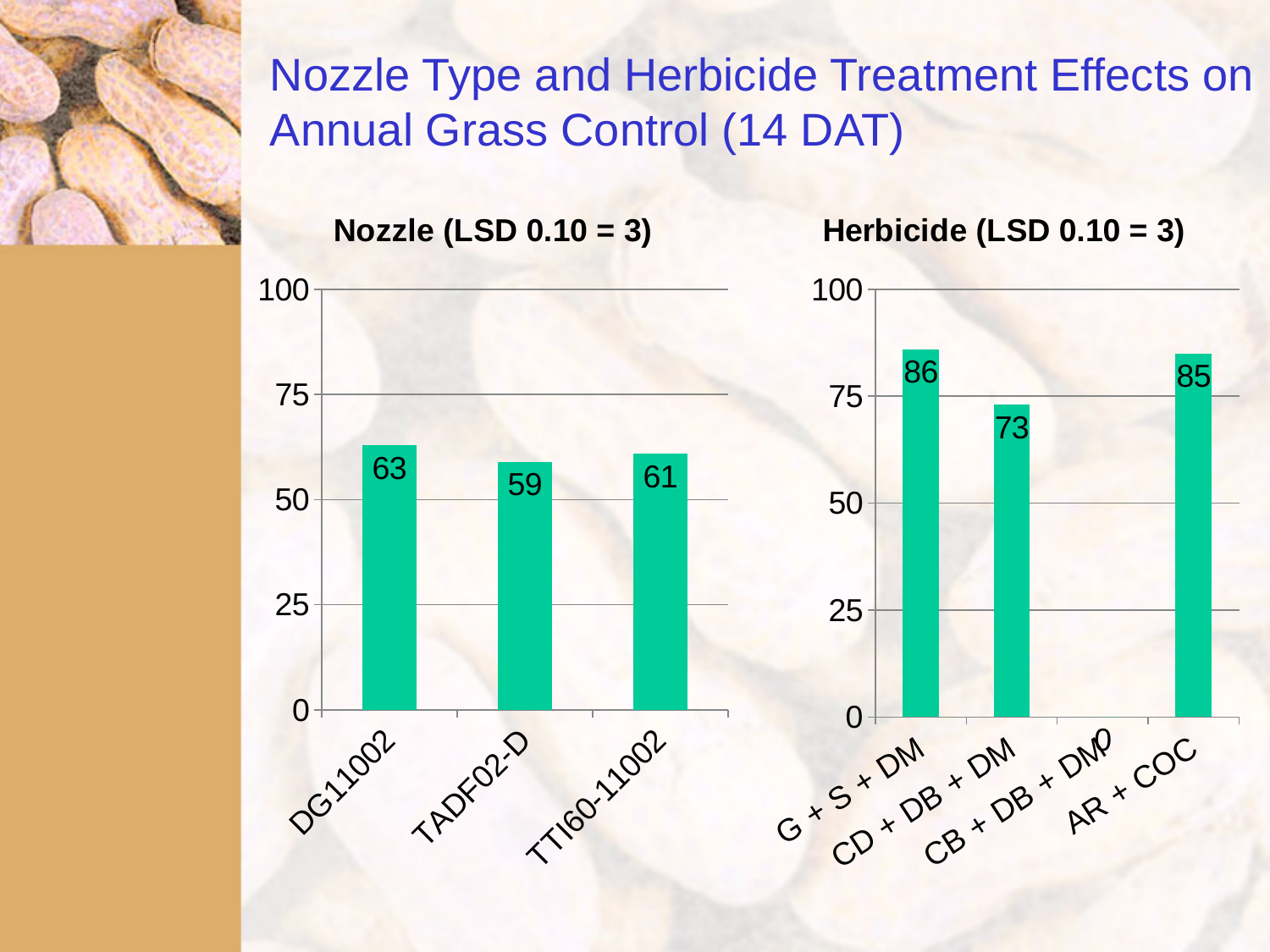
In the Nozzle (LSD 0.10 = 3) chart, which nozzle has the highest value? DG11002 In the Nozzle (LSD 0.10 = 3) chart, what is the value for TADF02-D? 59 In the Nozzle (LSD 0.10 = 3) chart, what is the value for DG11002? 63 In the Herbicide (LSD 0.10 = 3) chart, which treatment has the lowest value? CB + DB + DM In the Herbicide (LSD 0.10 = 3) chart, which is larger, G + S + DM or CD + DB + DM? G + S + DM In the Herbicide (LSD 0.10 = 3) chart, what is the value for AR + COC? 85 In the Herbicide (LSD 0.10 = 3) chart, what is the value for CD + DB + DM? 73 In the Herbicide (LSD 0.10 = 3) chart, what is the value for G + S + DM? 86 In the Nozzle (LSD 0.10 = 3) chart, what is the difference between DG11002 and TADF02-D? 4 What kind of chart is the Nozzle (LSD 0.10 = 3) chart? Bar chart In the Nozzle (LSD 0.10 = 3) chart, how many nozzle types are shown? 3 In the Nozzle (LSD 0.10 = 3) chart, which nozzle has the lowest value? TADF02-D